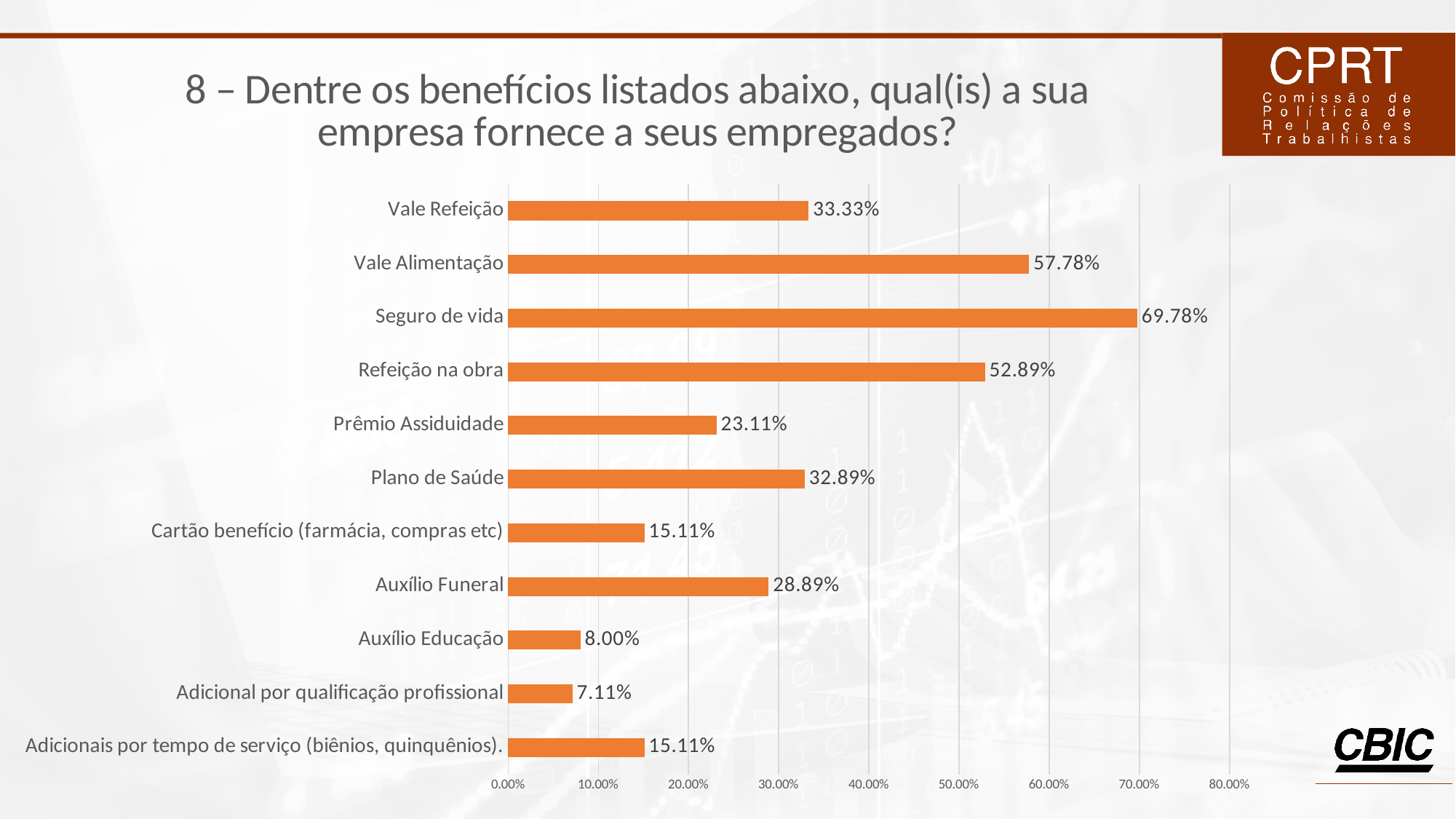
How many categories are shown in the chart? 11 What is the difference between Auxílio Funeral and Cartão benefício (farmácia, compras etc)? 13.78% Is the value for Prêmio Assiduidade greater or less than 20.00%? greater What is the value for Vale Alimentação? 57.78% Which is larger, Vale Refeição or Plano de Saúde? Vale Refeição What is the value for Seguro de vida? 69.78% What kind of chart is shown on the slide? Bar chart What colour are the bars in the chart? Orange What is the value for Auxílio Educação? 8.00% What is the difference between Seguro de vida and Refeição na obra? 16.89% Which category has the lowest value? Adicional por qualificação profissional Which category has the highest value? Seguro de vida